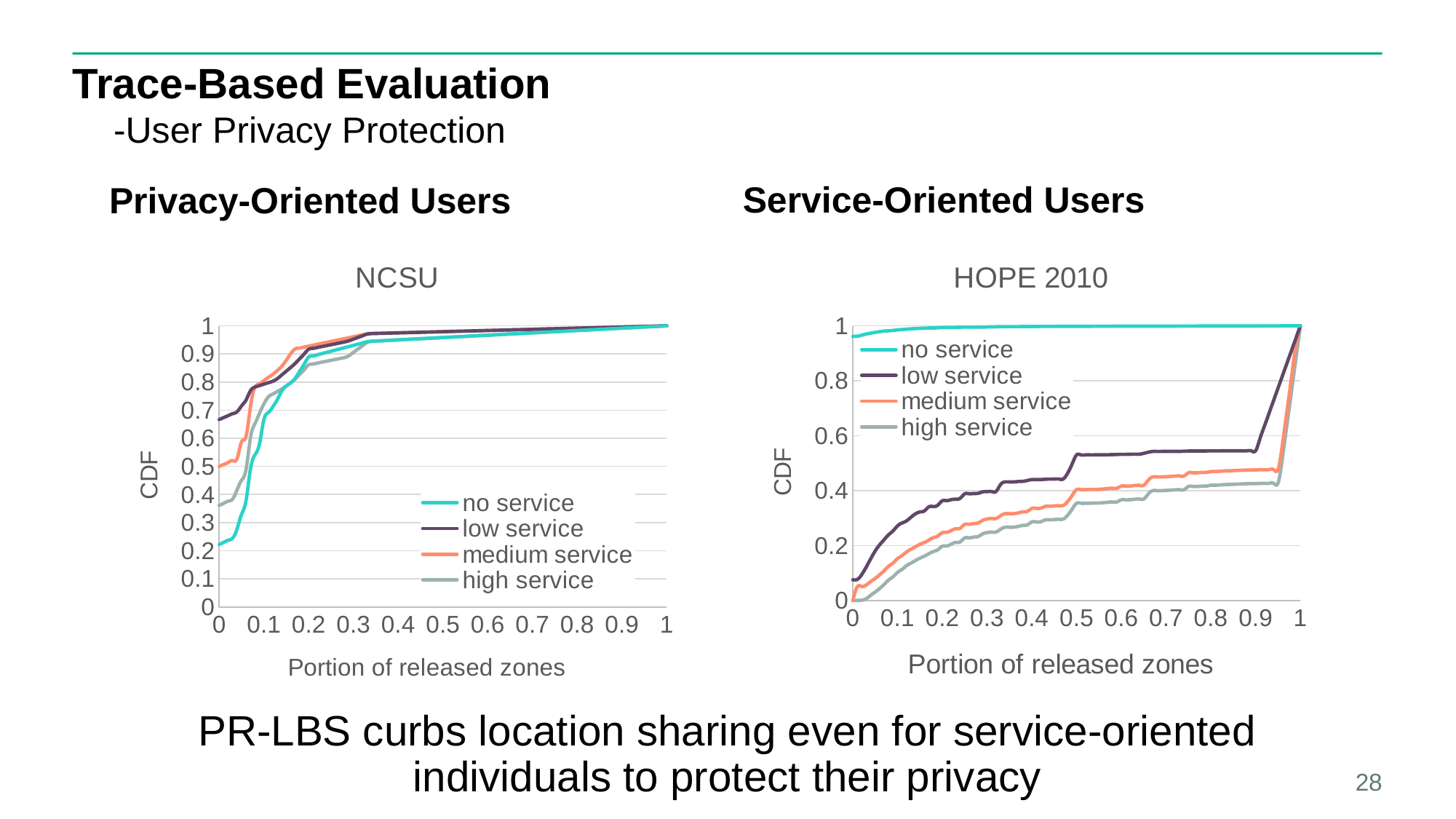
What type of chart is the NCSU chart? line chart In the HOPE 2010 chart, is the value of the high service line at a portion of released zones of 0.9 greater or less than 0.6? less How many series does the legend of the HOPE 2010 chart list? 4 In the NCSU chart, is the value of the low service line at a portion of released zones of 0 greater or less than 0.6? greater What is the label of the y axis on the HOPE 2010 chart? CDF In the NCSU chart, is the value of the no service line at a portion of released zones of 0 greater or less than 0.3? less What is the title of the chart under the heading Service-Oriented Users? HOPE 2010 In the HOPE 2010 chart, at a portion of released zones of 0.5, which is higher: the low service line or the high service line? low service In the HOPE 2010 chart, which series has the highest CDF value at a portion of released zones of 0.3? no service In the NCSU chart, do the CDF values rise or fall as the portion of released zones increases? rise In the NCSU chart, at a portion of released zones of 0, which is higher: the low service line or the no service line? low service